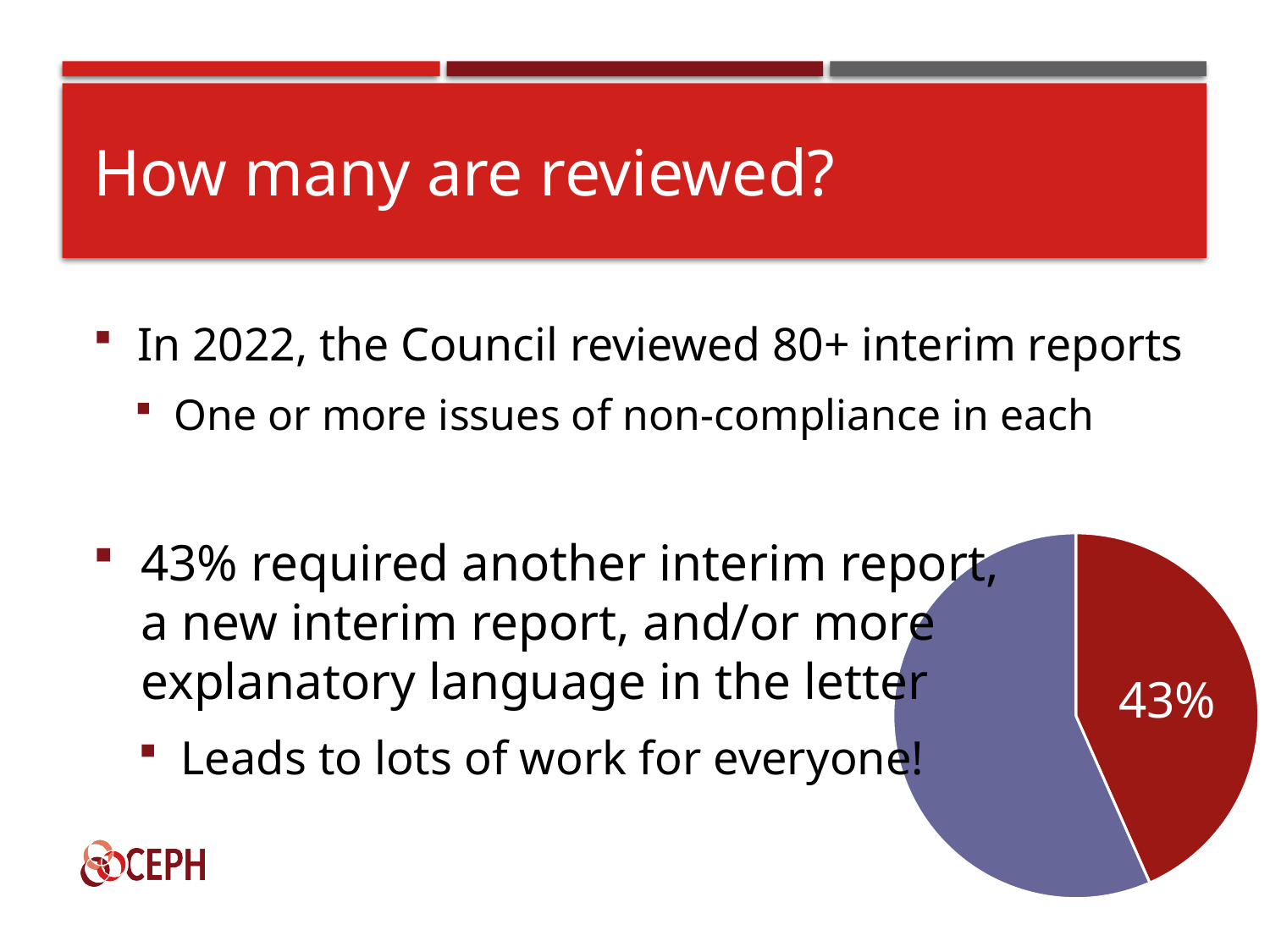
Which slice of the pie chart is larger, the red one or the purple one? purple How many slices does the pie chart have? 2 What kind of chart is shown on the slide? pie chart How many data labels are printed on the pie chart? 1 Which slice of the pie chart is the smallest? the red slice (43%) What share of the pie does the red slice represent? 43% What colour is the slice of the pie chart that carries the 43% label? red What value is labelled on the red slice of the pie chart? 43% Is the red slice of the pie chart greater or less than 50% of the pie? less